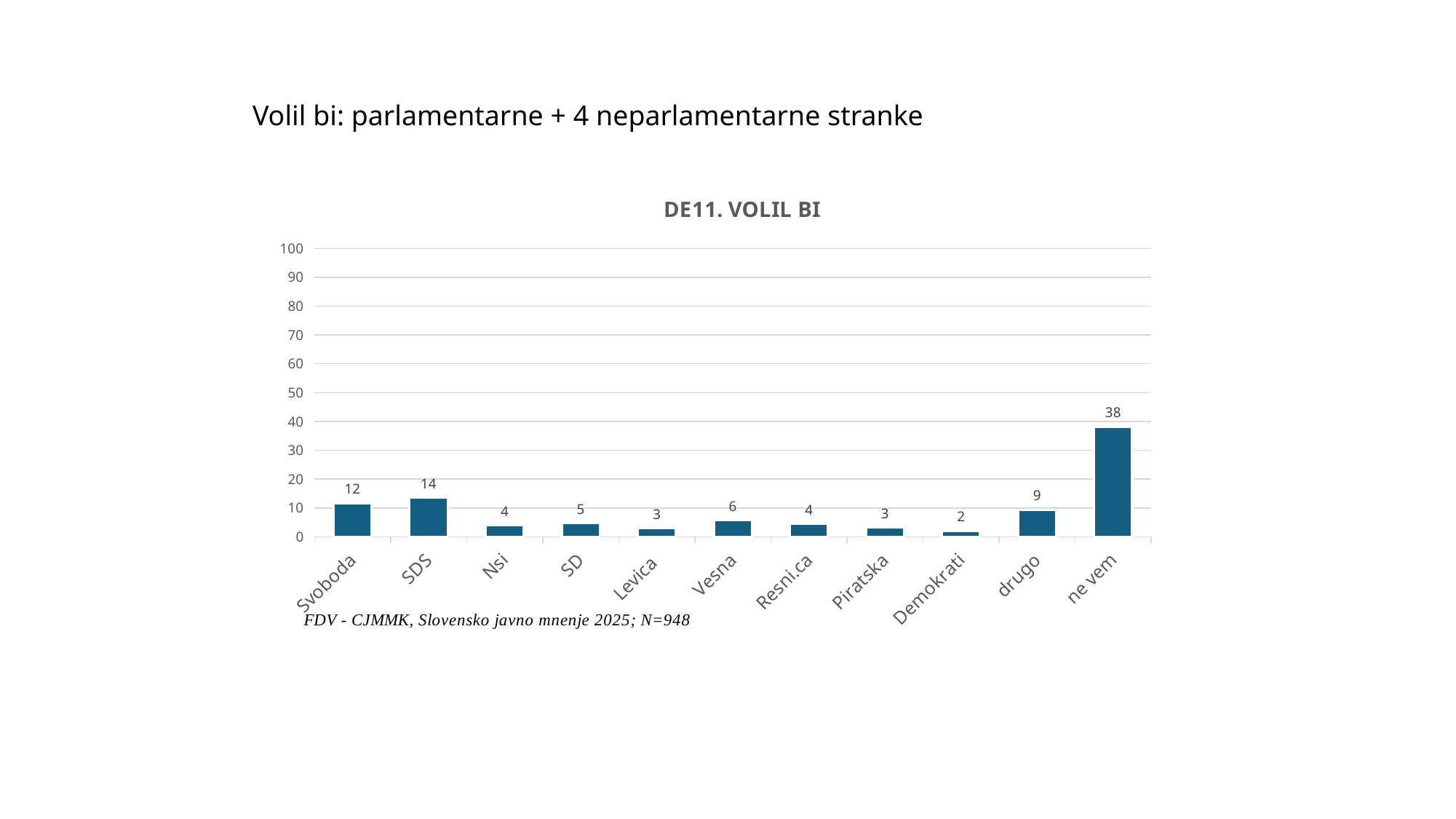
What kind of chart is this? bar chart Which category has the lowest value? Demokrati What is the difference between the values for SDS and Svoboda? 2 What is the value for ne vem? 38 Which is larger, the value for Svoboda or the value for SDS? SDS How many categories are shown on the x axis? 11 What is the value for Vesna? 6 What is the value for SDS? 14 What is the difference between the values for ne vem and drugo? 29 What is the value for drugo? 9 What is the title of the chart? DE11. VOLIL BI Which category has the highest value? ne vem